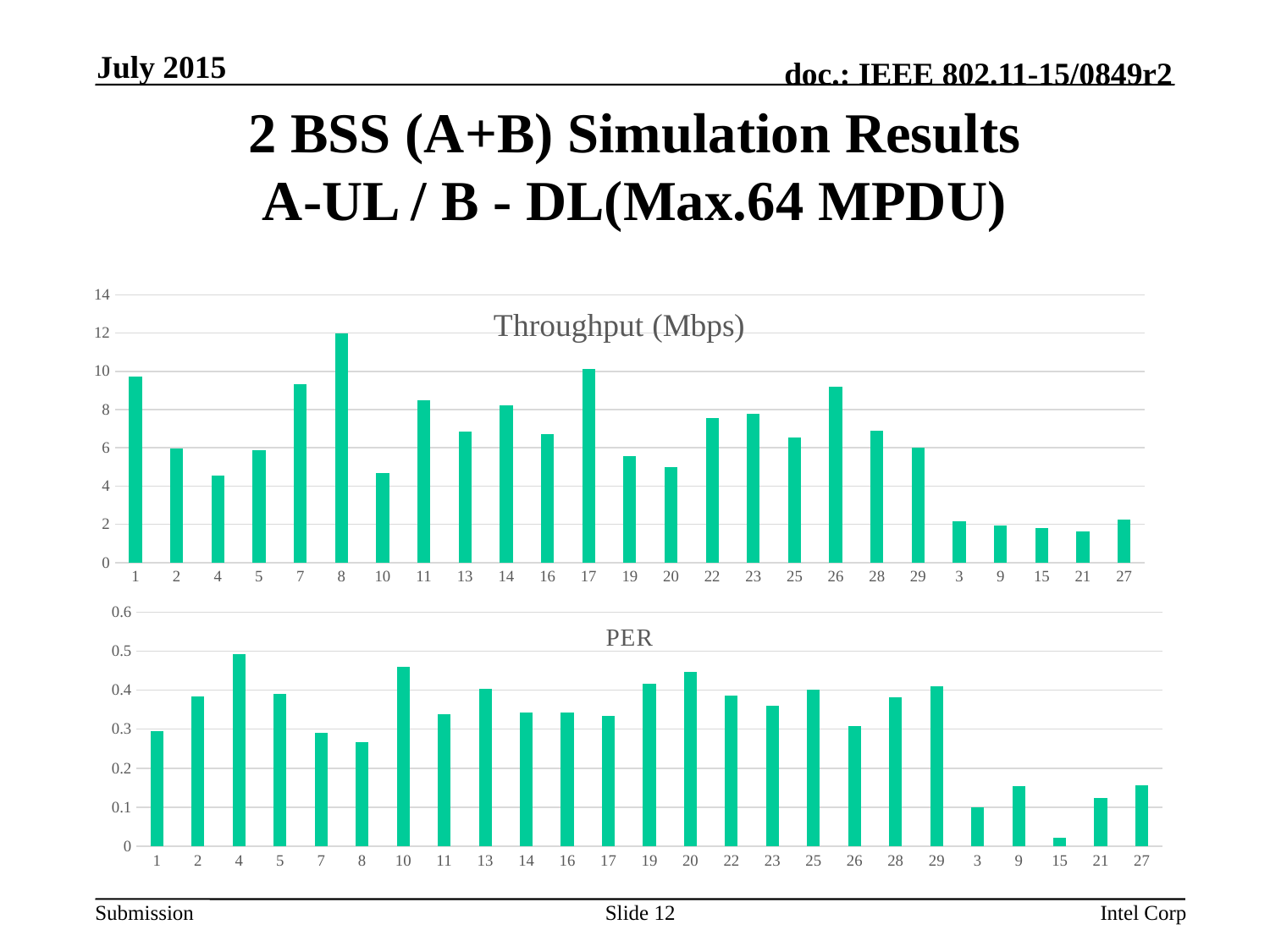
On the Throughput (Mbps) chart, which category has the highest value? 8 On the Throughput (Mbps) chart, is the value for category 26 greater or less than 8? greater What is the title of the lower chart on the slide? PER On the PER chart, is the value for category 8 greater or less than 0.3? less On the Throughput (Mbps) chart, is the value for category 3 greater or less than 4? less On the Throughput (Mbps) chart, which is larger, the value for category 8 or category 10? 8 On the PER chart, which is larger, the value for category 20 or category 7? 20 On the PER chart, which category has the lowest value? 15 What kind of chart is the Throughput (Mbps) chart? bar chart How many categories are plotted on the PER chart? 25